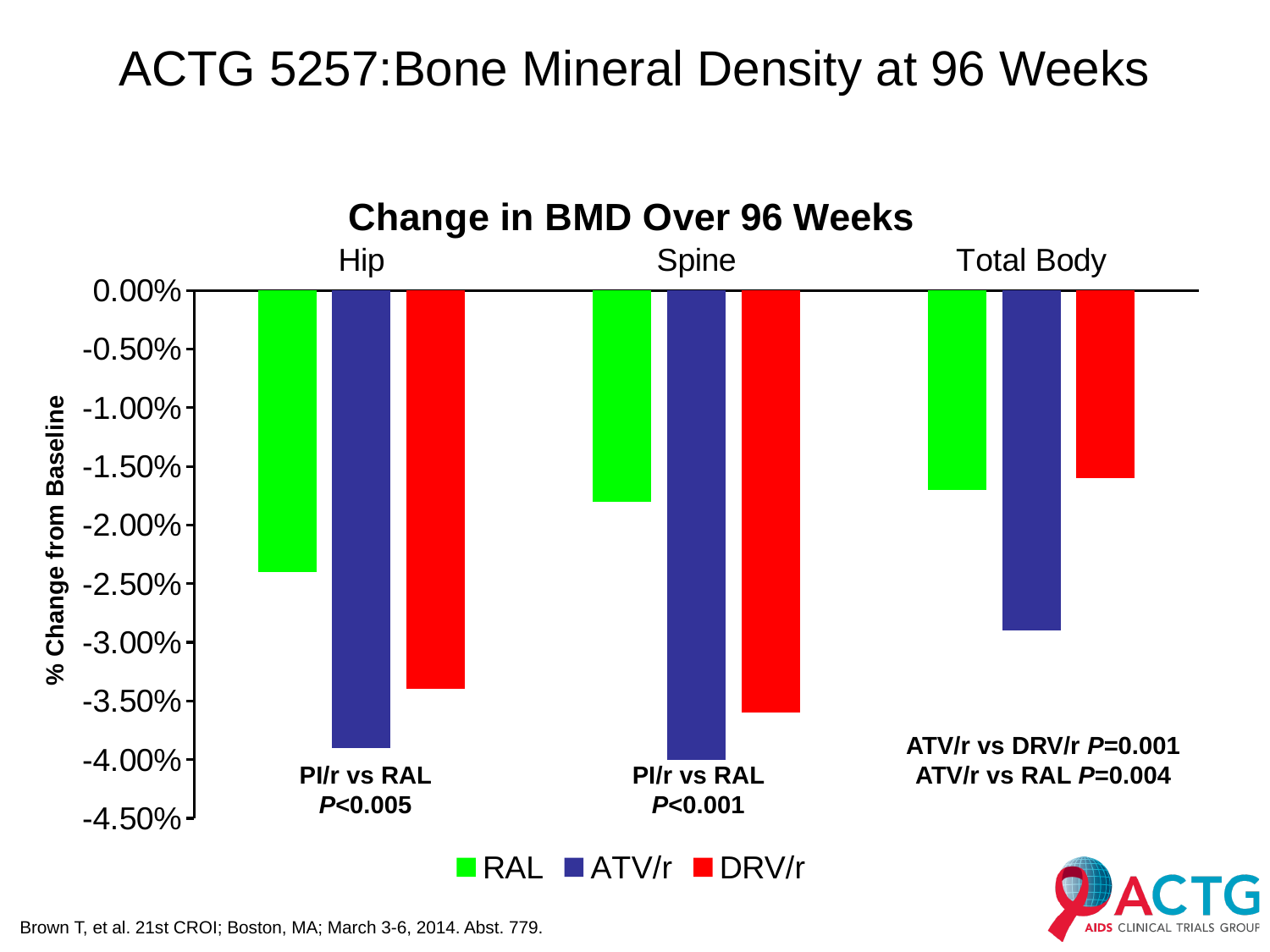
What is the label on the y axis? % Change from Baseline Is the value for ATV/r at the Spine greater or less than -3.50%? less What is the title of the chart? Change in BMD Over 96 Weeks Which series shows the largest decrease in BMD for Total Body? ATV/r Which series shows the largest decrease in BMD at the Hip? ATV/r Which series shows the smallest decrease in BMD at the Spine? RAL Is the value for RAL at the Hip greater or less than -2.00%? less Is the value for DRV/r for Total Body greater or less than -2.00%? greater How many series does the legend list? 3 What kind of chart is shown on the slide? bar chart At the Spine, which shows a larger decrease in BMD, RAL or DRV/r? DRV/r How many body-site categories are shown on the x axis? 3